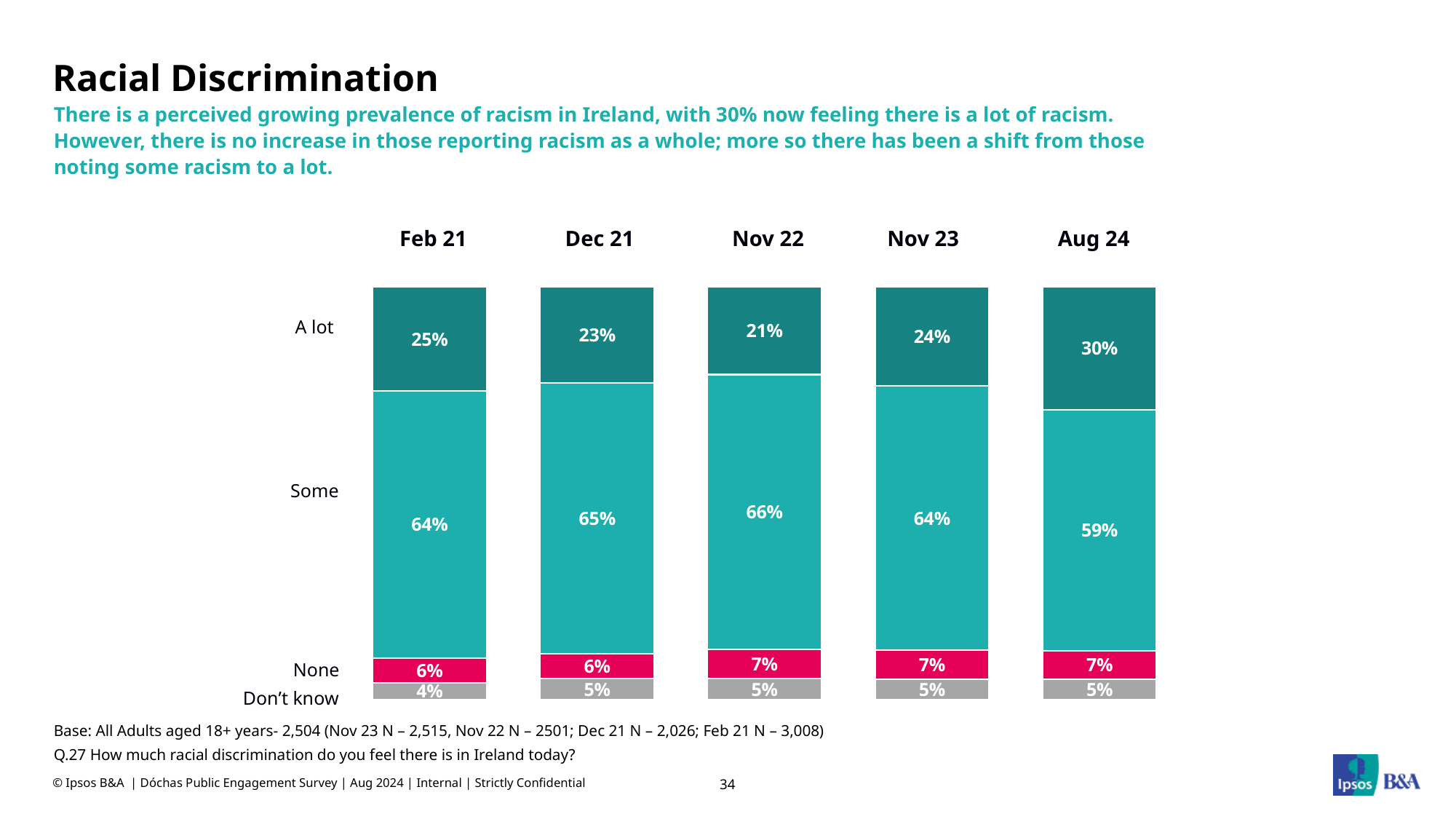
How many response categories are stacked in each bar? 4 How many time periods are shown in the chart? 5 What is the 'Don't know' value for Feb 21? 4% What is the difference between the 'A lot' value in Aug 24 and in Nov 23? 6 percentage points Which is larger: the 'Some' value in Dec 21 or in Aug 24? Dec 21 In which period is the 'Some' value lowest? Aug 24 What is the 'Some' value for Nov 22? 66% In which period is the 'A lot' value lowest? Nov 22 In which period is the 'A lot' value highest? Aug 24 What kind of chart is shown on the slide? Stacked bar chart What is the 'None' value for Dec 21? 6% What percentage of respondents said there is 'A lot' of racial discrimination in Aug 24? 30%